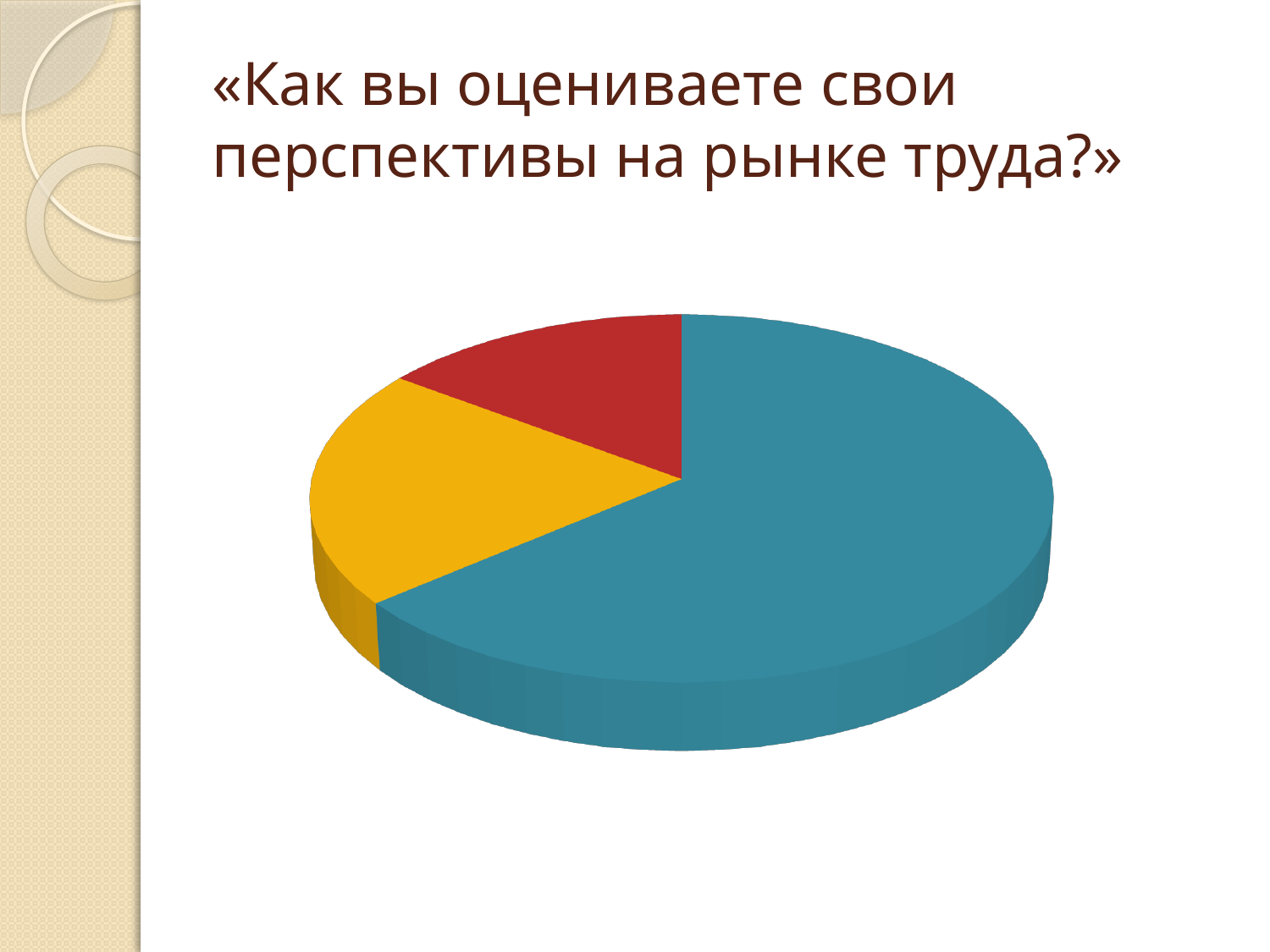
Which colour slice is the smallest in the pie chart? red Is the yellow slice larger or smaller than the red slice? larger Does the pie chart show a legend? No What kind of chart is shown on the slide? pie chart Is the blue slice larger or smaller than the yellow slice? larger What is the title of the slide above the chart? «Как вы оцениваете свои перспективы на рынке труда?» Does the blue slice take up more or less than half of the pie? more Which colour slice is the largest in the pie chart? blue How many slices does the pie chart have? 3